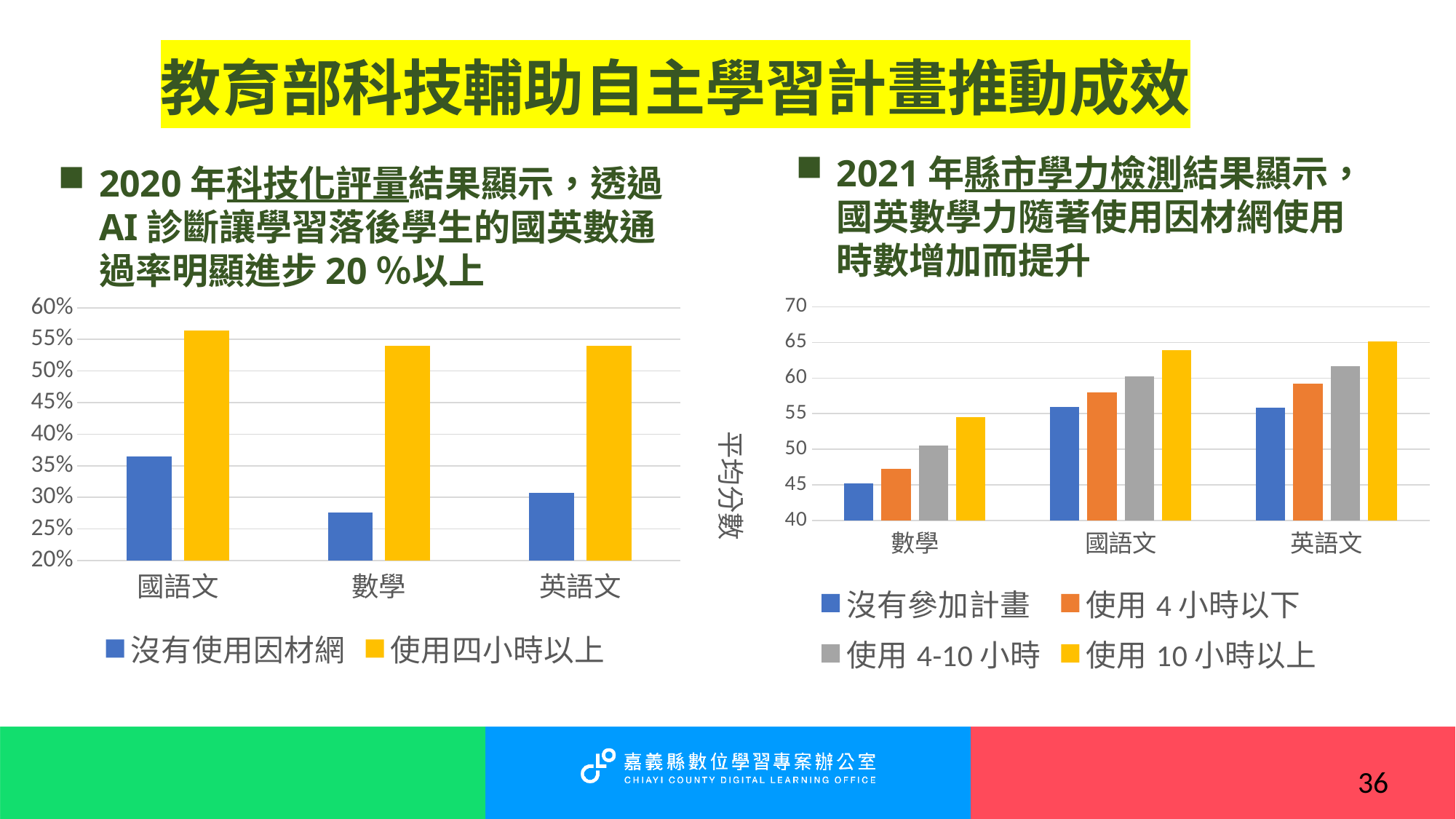
In the left chart (2020 科技化評量), which category has the lowest 沒有使用因材網 bar? 數學 In the right chart (2021 縣市學力檢測), is the value for 國語文 in the 使用 10 小時以上 series greater or less than 60? greater In the right chart (2021 縣市學力檢測), which is larger for the 沒有參加計畫 series: 數學 or 國語文? 國語文 In the left chart (2020 科技化評量), is the value for 數學 in the 沒有使用因材網 series greater or less than 30%? less How many series does the legend of the right chart (2021 縣市學力檢測) list? 4 In the left chart (2020 科技化評量), is the value for 國語文 in the 使用四小時以上 series greater or less than 50%? greater In the left chart (2020 科技化評量), which category has the highest 沒有使用因材網 bar? 國語文 In the right chart (2021 縣市學力檢測), do the bars within the 數學 group rise or fall from 沒有參加計畫 to 使用 10 小時以上? rise How many categories are shown on the x axis of the right chart (2021 縣市學力檢測)? 3 How many series does the legend of the left chart (2020 科技化評量) list? 2 What kind of chart is the left chart (2020 科技化評量)? bar chart What is the y-axis title of the right chart (2021 縣市學力檢測)? 平均分數